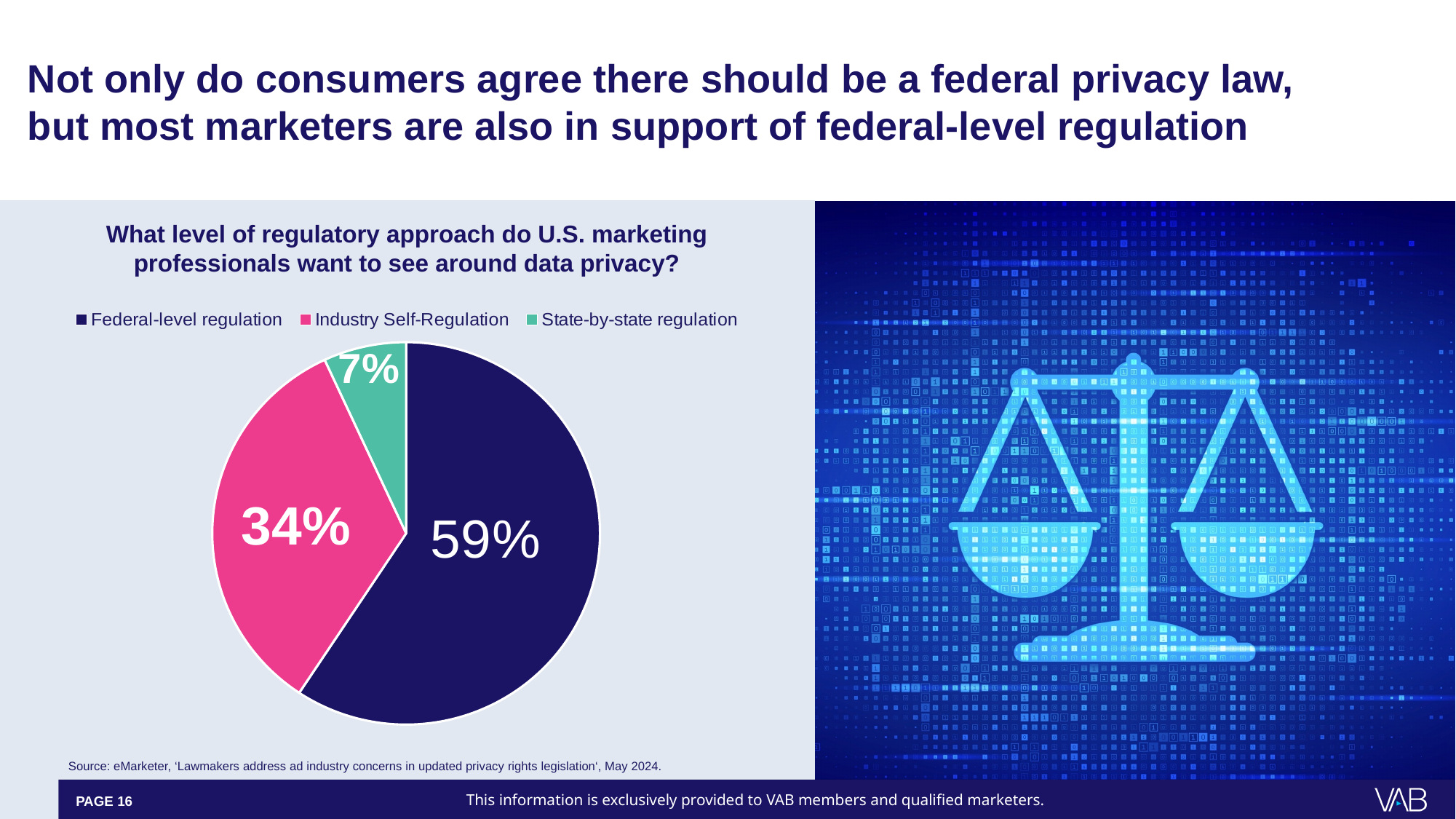
Which regulatory approach has the smallest share of the pie? State-by-state regulation What is the title of the chart? What level of regulatory approach do U.S. marketing professionals want to see around data privacy? How many categories does the pie chart show? 3 What is the difference in percentage points between Federal-level regulation and Industry Self-Regulation? 25 percentage points What is the difference in percentage points between Industry Self-Regulation and State-by-state regulation? 27 percentage points What colour is the slice for Industry Self-Regulation? Pink What share of U.S. marketing professionals want State-by-state regulation? 7% Which regulatory approach has the largest share of the pie? Federal-level regulation What share of U.S. marketing professionals want Industry Self-Regulation? 34% What kind of chart is shown on the slide? Pie chart What share of U.S. marketing professionals want Federal-level regulation? 59% Which is larger: the share for Industry Self-Regulation or the share for State-by-state regulation? Industry Self-Regulation